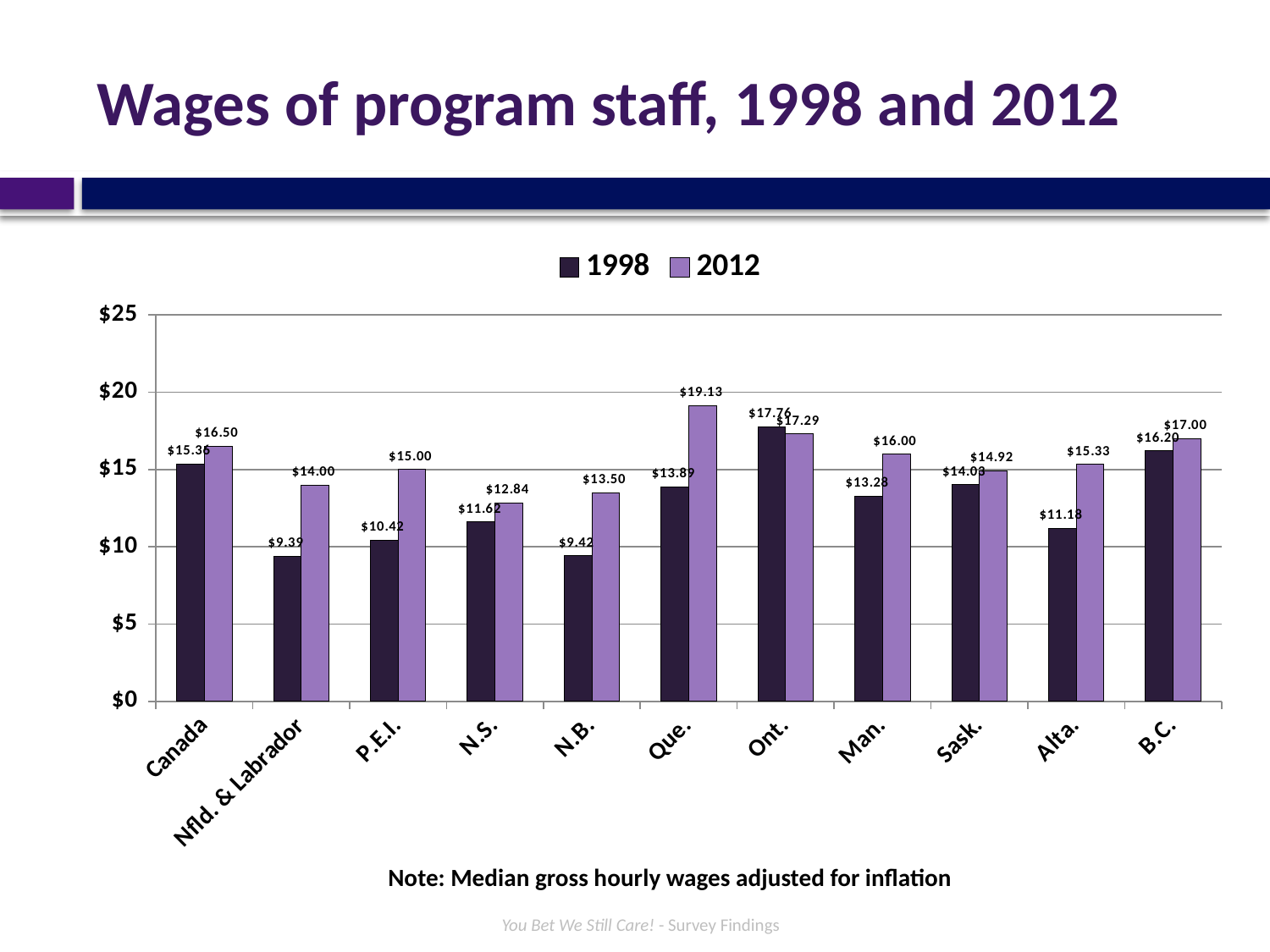
What is the 2012 wage for Alta.? $15.33 What is the 1998 wage for P.E.I.? $10.42 What kind of chart is shown on the slide? Bar chart Which category has the highest 2012 wage? Que. What is the difference between the 2012 and 1998 wages for Que.? $5.24 What is the 2012 wage for Que.? $19.13 How many series does the legend list? 2 Which category has the highest 1998 wage? Ont. How many categories are shown on the x axis? 11 Which category has the lowest 2012 wage? N.S. For Ont., which year has the higher wage, 1998 or 2012? 1998 Is the 1998 wage for Alta. greater or less than $15? less